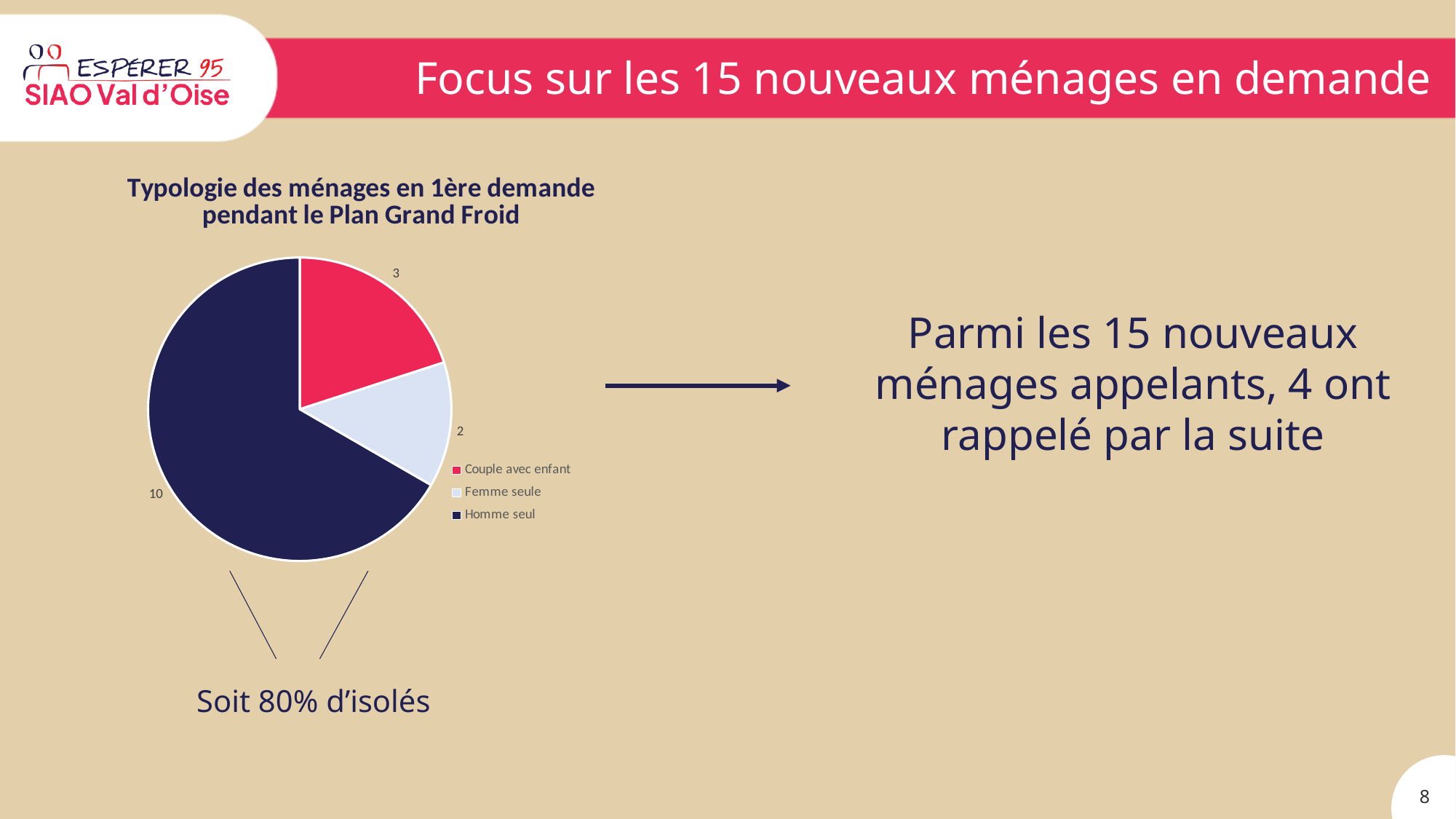
What is the value for Couple avec enfant in the pie chart? 3 What share of the pie does Couple avec enfant represent? 20% What is the total of all the values in the pie chart? 15 Which category has the largest slice of the pie chart? Homme seul Which is larger, the value for Couple avec enfant or the value for Femme seule? Couple avec enfant What is the value for Homme seul in the pie chart? 10 How many categories does the pie chart show? 3 Which category has the smallest slice of the pie chart? Femme seule What is the difference between the values for Homme seul and Couple avec enfant? 7 What is the value for Femme seule in the pie chart? 2 What is the title of the pie chart? Typologie des ménages en 1ère demande pendant le Plan Grand Froid What type of chart is shown on the slide? Pie chart